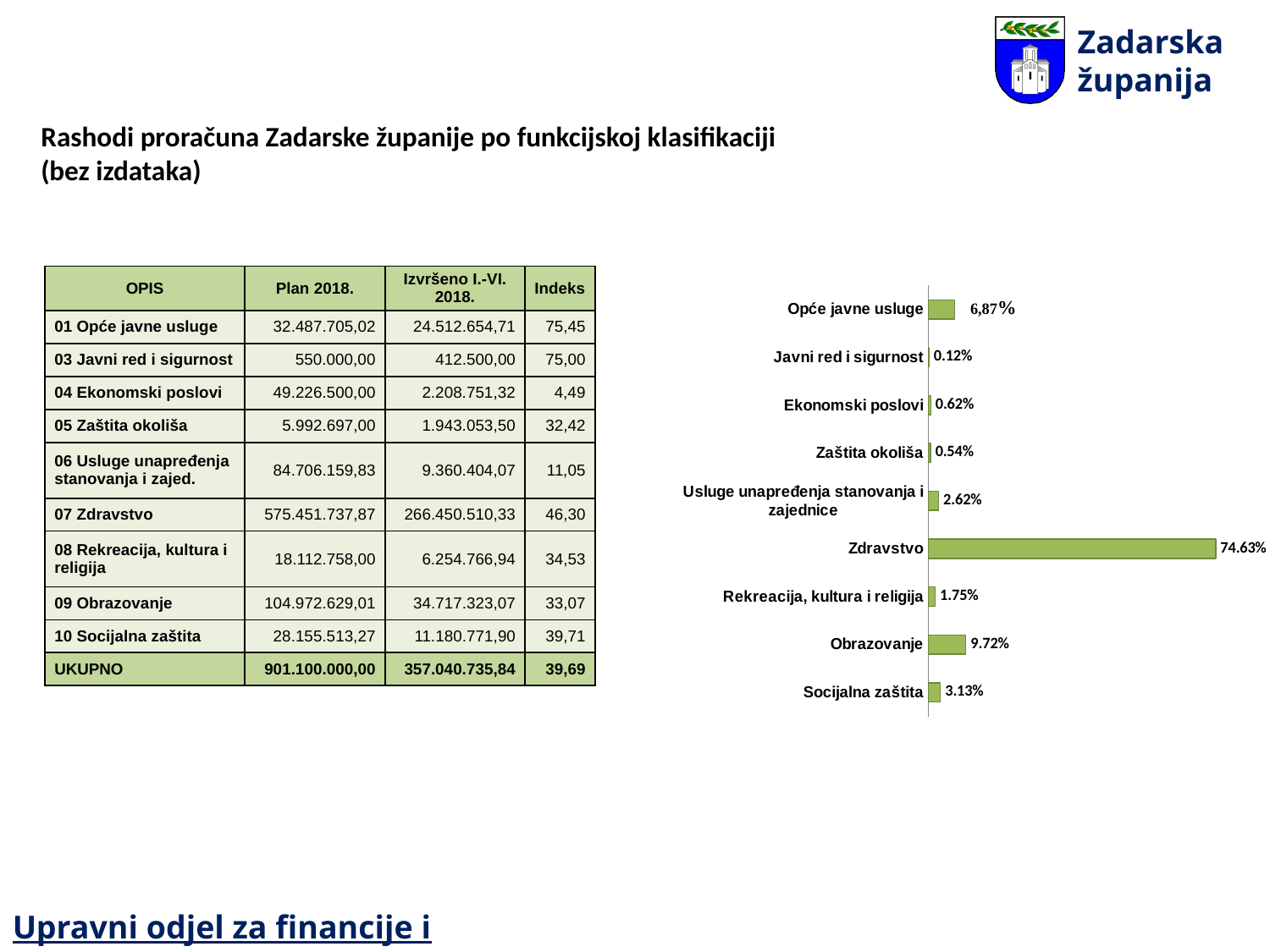
Which is larger in the bar chart, Obrazovanje or Socijalna zaštita? Obrazovanje Which category has the highest value in the bar chart? Zdravstvo How many categories does the bar chart show? 9 What is the value shown for Javni red i sigurnost in the bar chart? 0.12% What is the value shown for Zdravstvo in the bar chart? 74.63% What is the value shown for Usluge unapređenja stanovanja i zajednice in the bar chart? 2.62% What is the value shown for Obrazovanje in the bar chart? 9.72% What is the difference between the values for Zdravstvo and Obrazovanje in the bar chart? 64.91% What colour are the bars in the chart? green Which category has the lowest value in the bar chart? Javni red i sigurnost What kind of chart is shown on the slide? bar chart What is the value shown for Socijalna zaštita in the bar chart? 3.13%